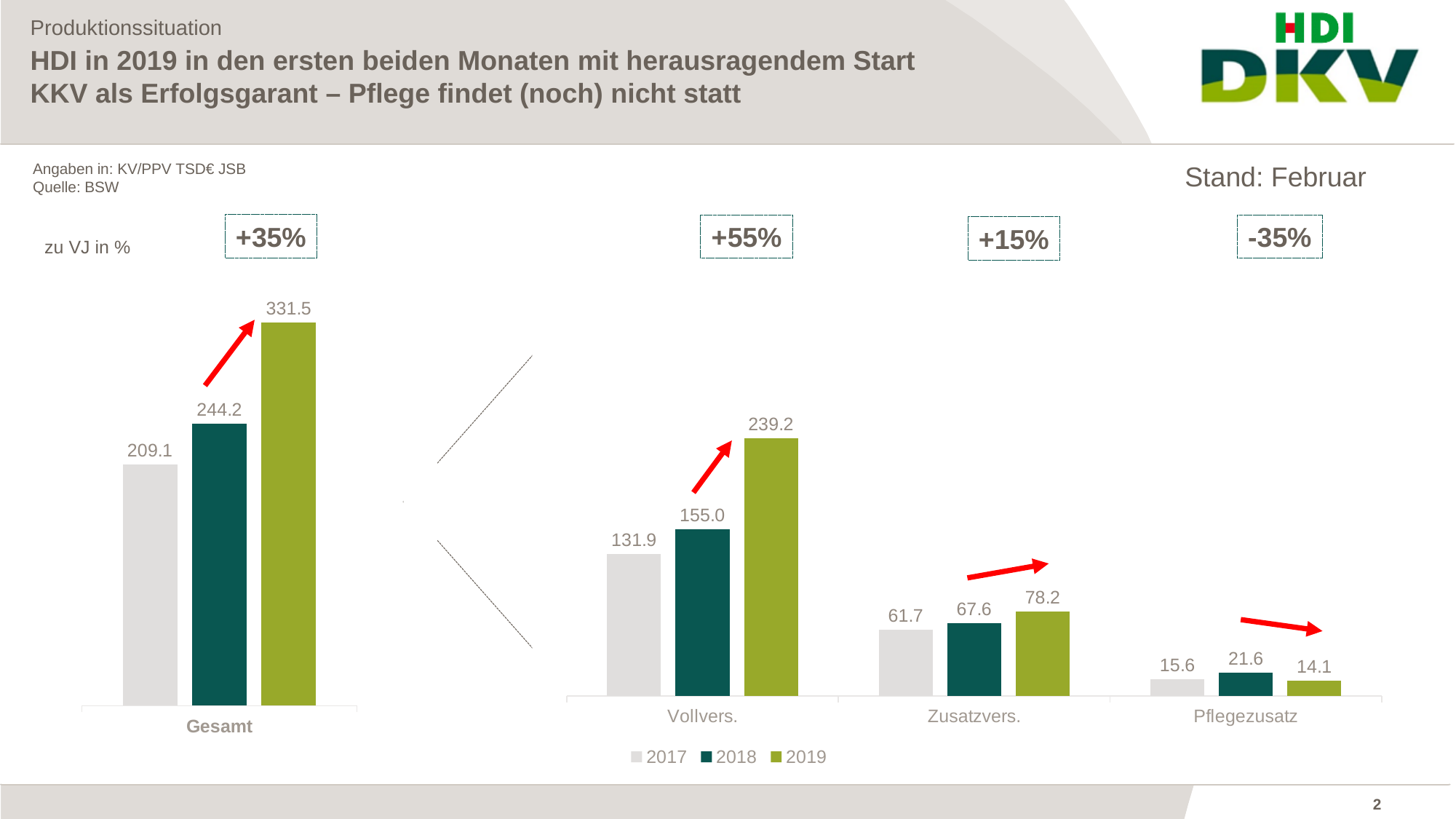
How many series does the legend of the right chart list? 3 In the left chart (Gesamt), what is the value for 2019? 331.5 In the right chart, which category has the highest 2018 value? Vollvers. How many categories are shown on the x axis of the right chart? 3 In the right chart, what is the 2018 value for Pflegezusatz? 21.6 In the left chart (Gesamt), what is the difference between the 2019 and 2018 values? 87.3 In the left chart (Gesamt), what is the value for 2017? 209.1 In the right chart, what is the 2019 value for Vollvers.? 239.2 In the right chart, is the 2019 value for Zusatzvers. larger or smaller than its 2018 value? larger In the right chart, what is the difference between the 2018 and 2019 values for Pflegezusatz? 7.5 What type of chart is the right chart? bar chart In the right chart, which category has the lowest 2019 value? Pflegezusatz